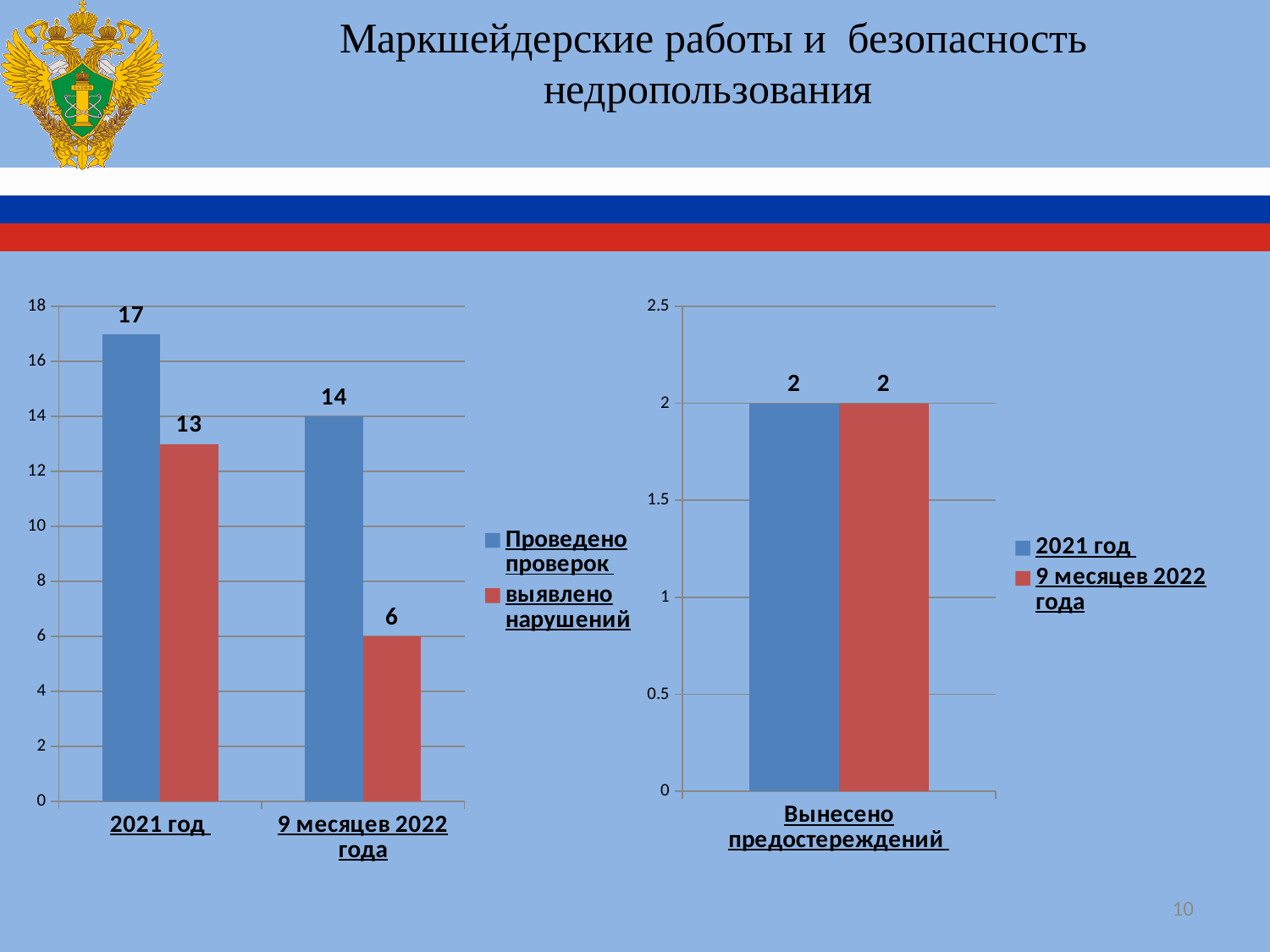
In the left chart, how many 'Проведено проверок' were there in 2021 год? 17 In the right chart, what is the value of 'Вынесено предостережений' for 9 месяцев 2022 года? 2 In the left chart, how many series does the legend list? 2 In the left chart, what is the difference between 'Проведено проверок' and 'выявлено нарушений' for 9 месяцев 2022 года? 8 What kind of chart is the right chart? bar chart In the left chart, what colour are the 'выявлено нарушений' bars? red In the left chart, is 'выявлено нарушений' larger in 2021 год or in 9 месяцев 2022 года? 2021 год In the left chart, how many categories are shown on the x axis? 2 In the left chart, what is the value of 'выявлено нарушений' for 9 месяцев 2022 года? 6 In the left chart, which category has the highest 'Проведено проверок' value? 2021 год In the left chart, what is the value of 'выявлено нарушений' for 2021 год? 13 In the right chart, what is the value of 'Вынесено предостережений' for 2021 год? 2